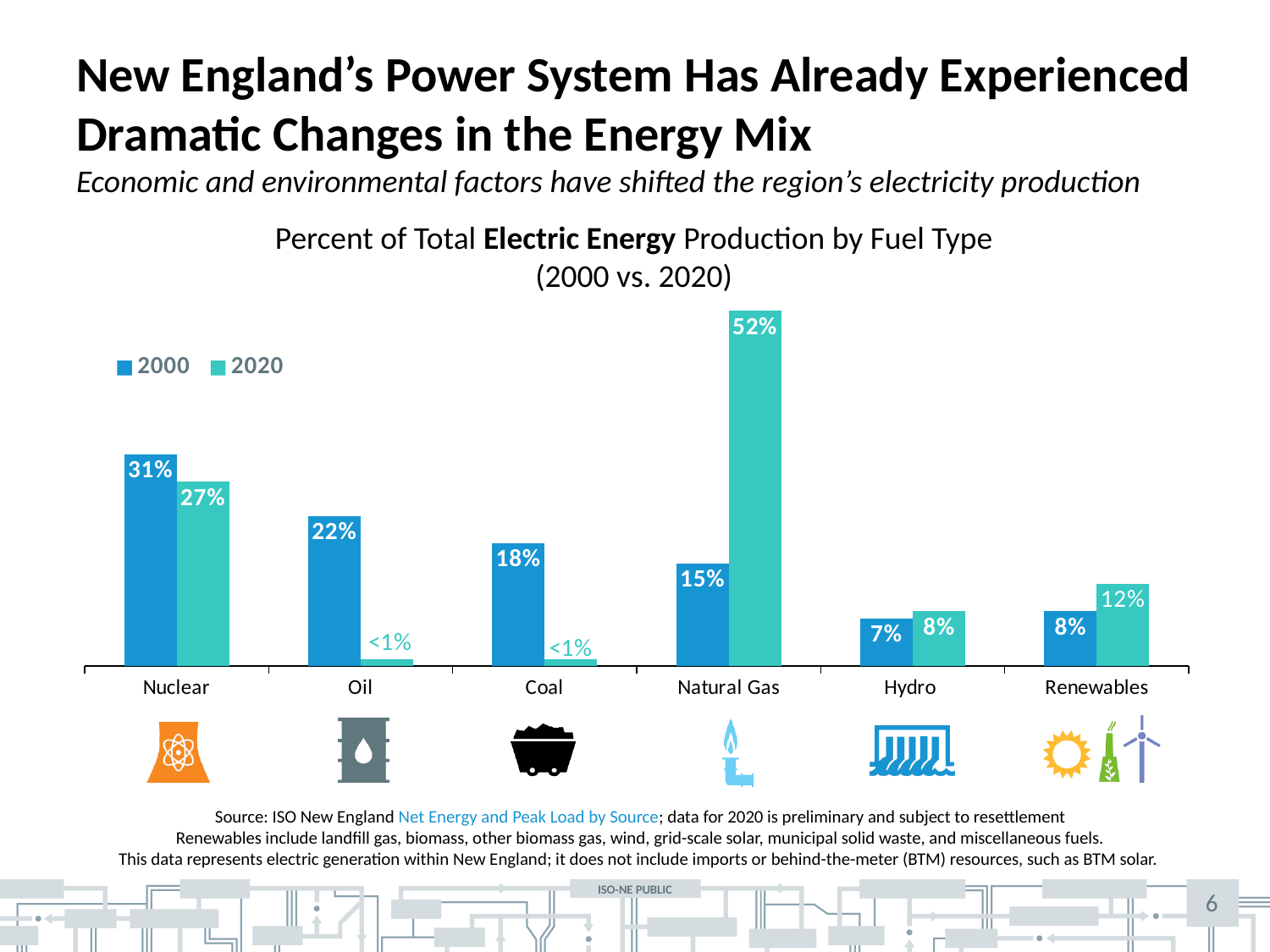
What kind of chart is shown on the slide? Bar chart Which fuel type had the highest share in 2020? Natural Gas Which was larger in 2000: the share of Oil or the share of Coal? Oil What was the share of Oil in 2020? <1% How many series does the legend list? 2 What was the share of Nuclear in 2000? 31% Did the share of Renewables rise or fall from 2000 to 2020? Rise How many fuel types are shown on the x axis? 6 By how many percentage points did the Natural Gas share change from 2000 to 2020? 37 percentage points What was the share of Natural Gas in 2020? 52% Which fuel type had the lowest share in 2000? Hydro Which two years does the chart compare? 2000 and 2020